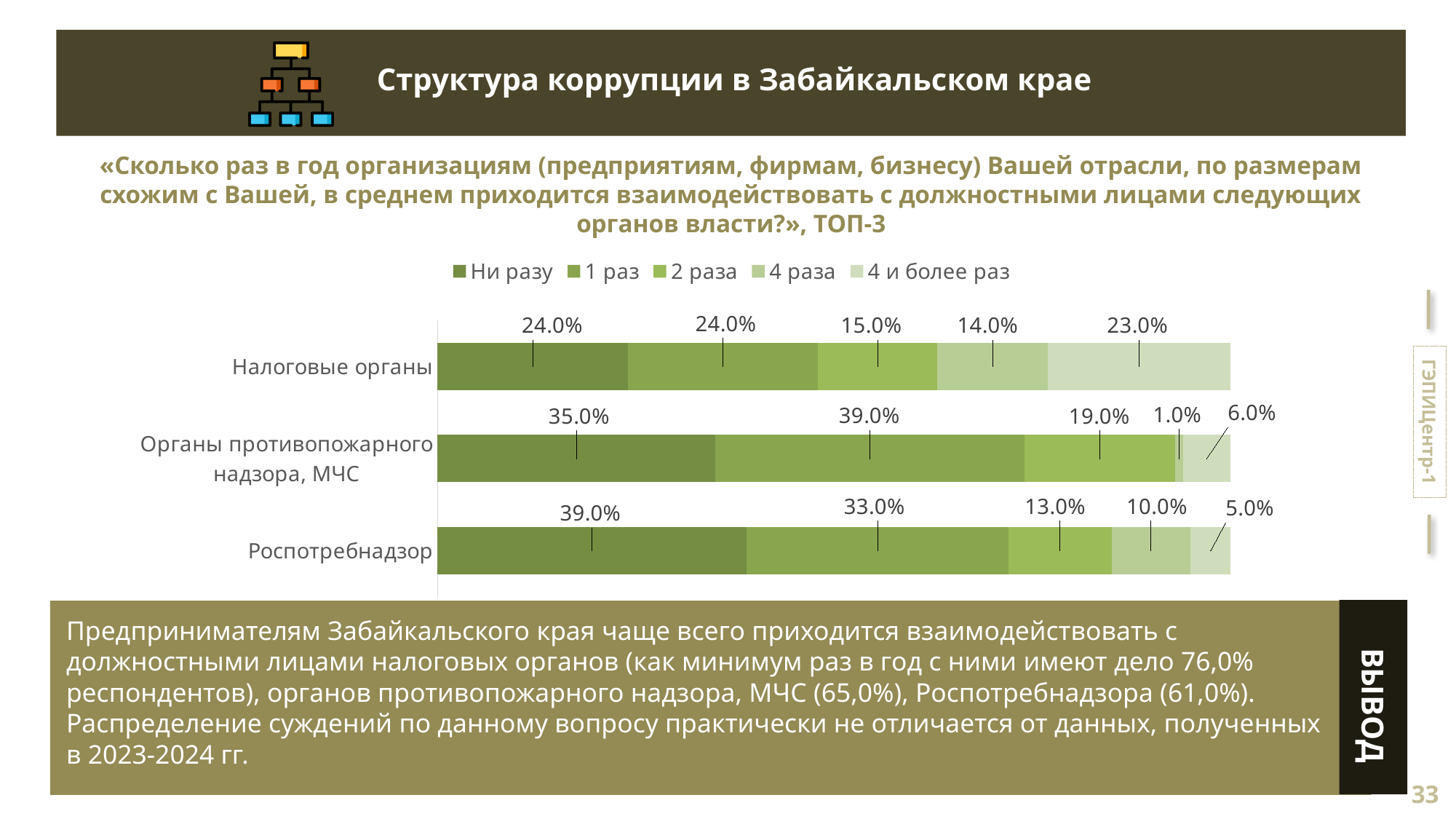
What is the value of "1 раз" for Органы противопожарного надзора, МЧС? 39.0% What is the value of "Ни разу" for Налоговые органы? 24.0% Which is larger: the "2 раза" value for Органы противопожарного надзора, МЧС or for Роспотребнадзор? Органы противопожарного надзора, МЧС How many categories (government bodies) are shown on the chart? 3 How many series does the legend list? 5 What is the value of "4 и более раз" for Роспотребнадзор? 5.0% What is the total of the stacked bar for Налоговые органы? 100.0% Which category has the lowest value for "4 и более раз"? Роспотребнадзор Which category has the highest value for "Ни разу"? Роспотребнадзор What is the difference between the "4 и более раз" values for Налоговые органы and Роспотребнадзор? 18.0% What is the value of "4 раза" for Органы противопожарного надзора, МЧС? 1.0% What type of chart is shown on the slide? Stacked bar chart